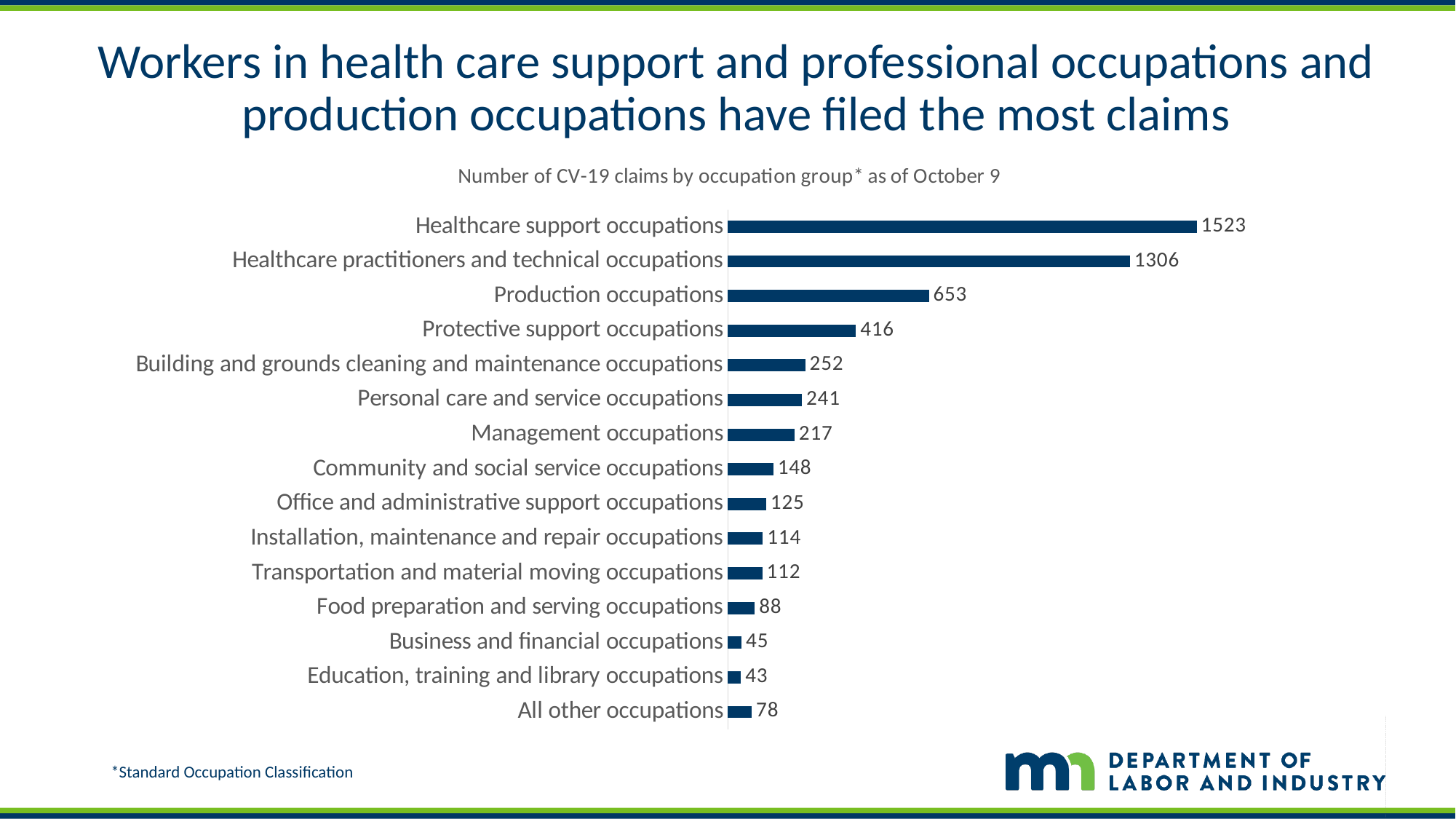
What is the difference in claims between Protective support occupations and Production occupations? 237 Which has more claims, Personal care and service occupations or Building and grounds cleaning and maintenance occupations? Building and grounds cleaning and maintenance occupations What is the number of claims for Production occupations? 653 What is the difference in claims between Healthcare support occupations and Healthcare practitioners and technical occupations? 217 What type of chart is shown on the slide? Bar chart Which occupation group has the lowest number of claims? Education, training and library occupations How many claims were filed by Management occupations? 217 What is the subtitle of the chart? Number of CV-19 claims by occupation group* as of October 9 Which occupation group has the highest number of claims? Healthcare support occupations How many CV-19 claims were filed by Healthcare support occupations? 1523 Which has more claims, Food preparation and serving occupations or All other occupations? Food preparation and serving occupations How many occupation groups are shown in the chart? 15